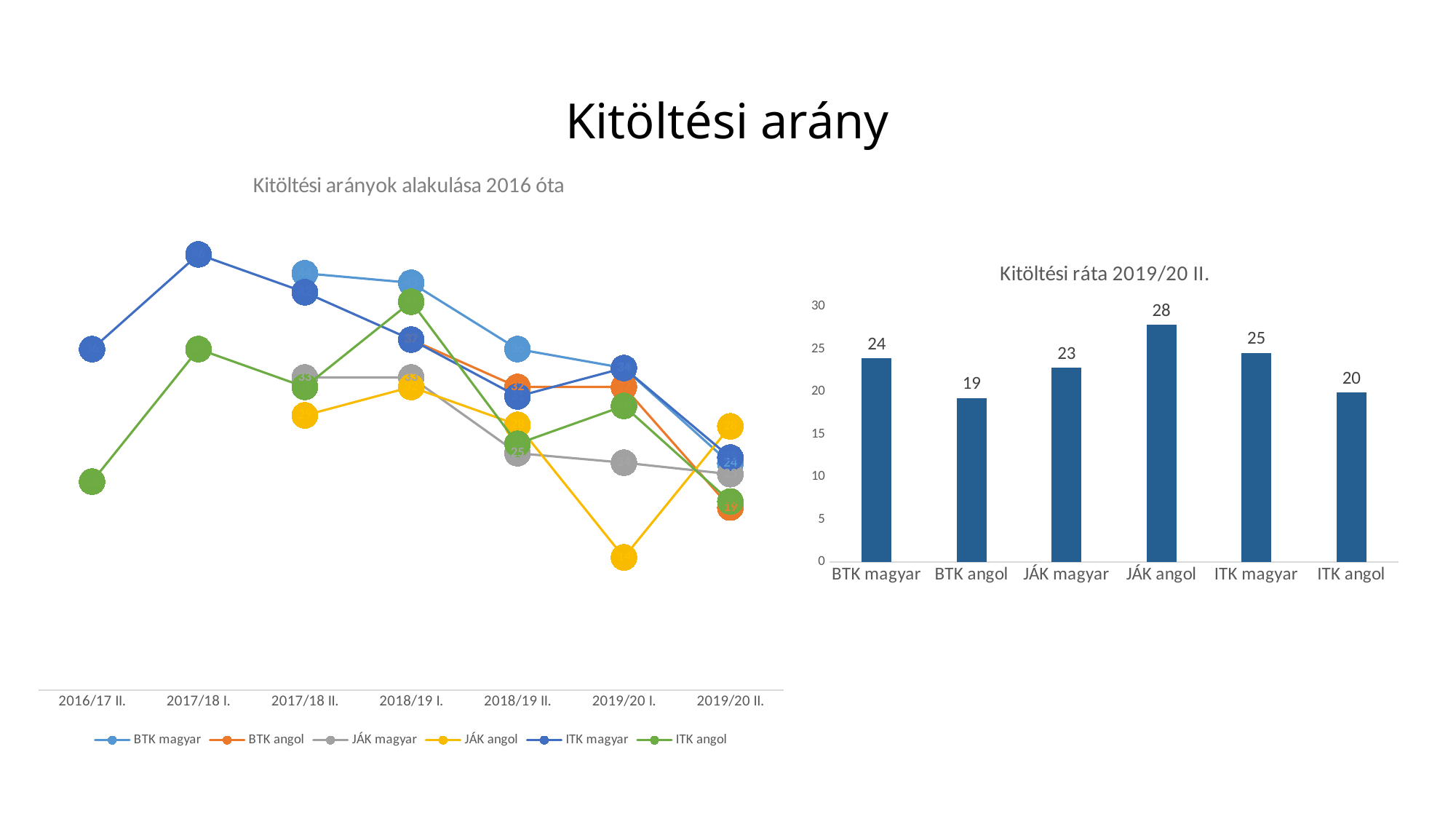
In the chart titled 'Kitöltési ráta 2019/20 II.', what is the difference between the values for JÁK angol and BTK angol? 9 How many series does the legend of the chart titled 'Kitöltési arányok alakulása 2016 óta' list? 6 How many bars are shown in the chart titled 'Kitöltési ráta 2019/20 II.'? 6 What kind of chart is the one titled 'Kitöltési ráta 2019/20 II.'? bar chart How many time periods are shown on the x axis of the chart titled 'Kitöltési arányok alakulása 2016 óta'? 7 In the chart titled 'Kitöltési ráta 2019/20 II.', which is larger, the value for ITK magyar or the value for ITK angol? ITK magyar In the chart titled 'Kitöltési ráta 2019/20 II.', which category has the highest value? JÁK angol In the chart titled 'Kitöltési ráta 2019/20 II.', what is the value for JÁK angol? 28 In the chart titled 'Kitöltési ráta 2019/20 II.', which category has the lowest value? BTK angol In the chart titled 'Kitöltési ráta 2019/20 II.', what is the value for BTK magyar? 24 In the chart titled 'Kitöltési ráta 2019/20 II.', is the value for JÁK magyar greater or less than 20? greater